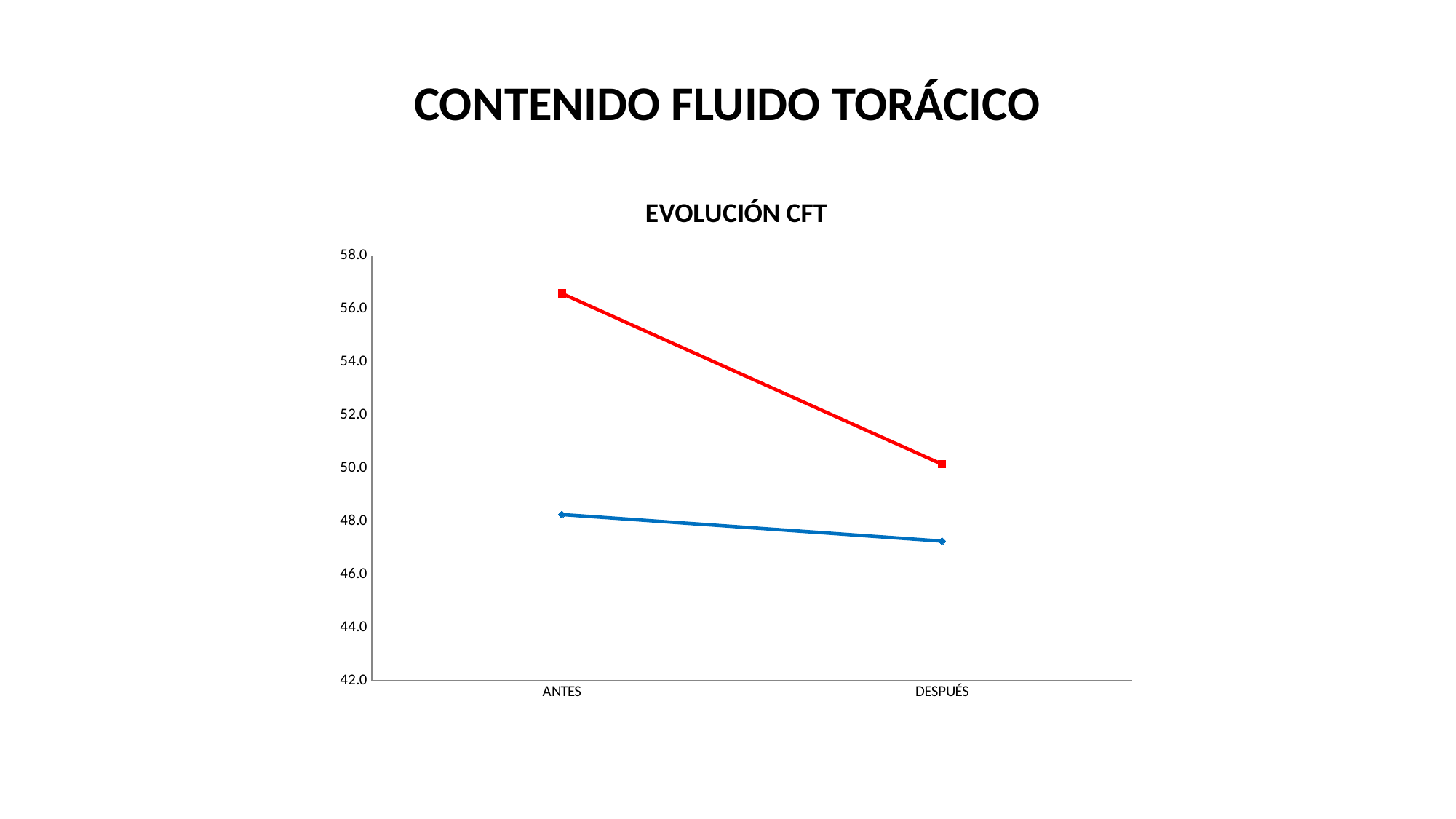
Is the value of the red line at ANTES greater or less than 54.0? greater How many lines are plotted on the chart? 2 Is the value of the blue line at ANTES greater or less than 50.0? less At ANTES, which line has the higher value, the red line or the blue line? the red line Does the blue line rise or fall from ANTES to DESPUÉS? fall What is the title of the chart? EVOLUCIÓN CFT What kind of chart is shown on the slide? line chart What colours are the two lines on the chart? red and blue Is the value of the blue line at DESPUÉS greater or less than 46.0? greater How many categories are shown on the x axis? 2 Does the red line rise or fall from ANTES to DESPUÉS? fall